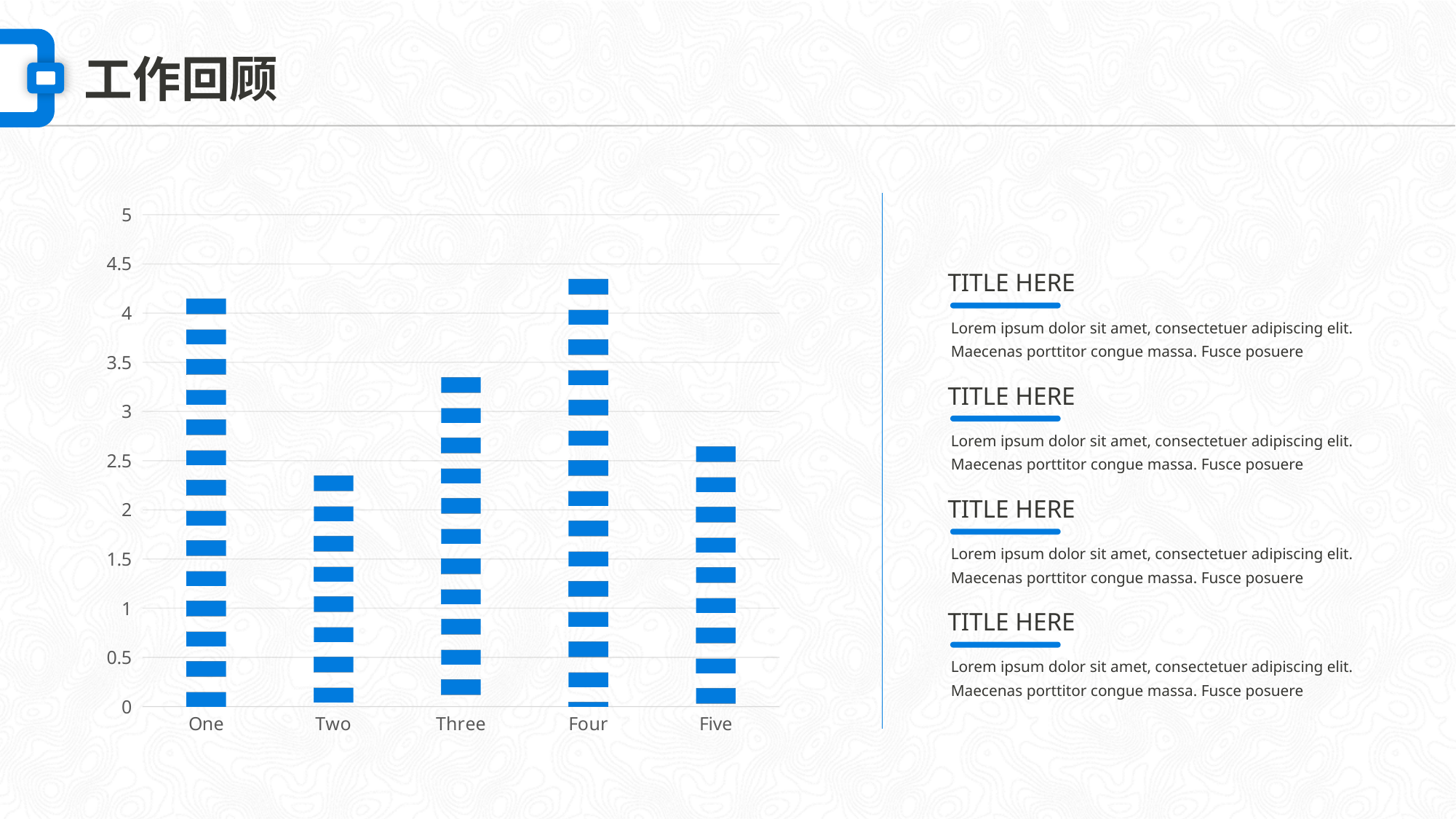
Is the value for One greater or less than 4? greater Which is larger, the value for Five or the value for Two? Five What kind of chart is shown on the slide? bar chart What is the highest value shown on the chart's vertical axis? 5 Which is larger, the value for One or the value for Three? One Is the value for Three greater or less than 3? greater Which category has the highest bar in the chart? Four How many categories are shown on the x axis of the chart? 5 Which category has the lowest bar in the chart? Two Is the value for Five greater or less than 2.5? greater